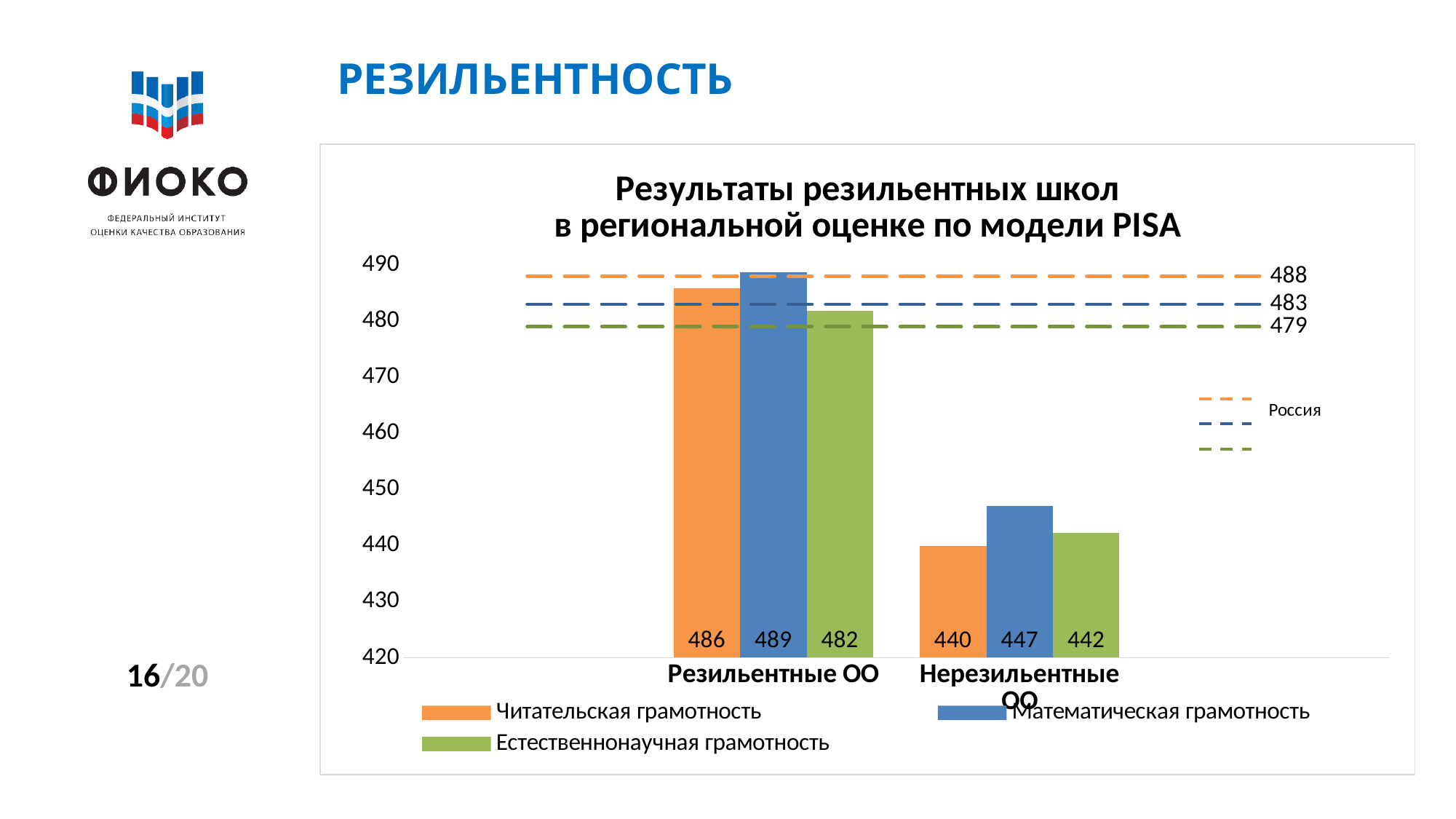
What is the value of Математическая грамотность for Резильентные ОО? 489 What is the value of Естественнонаучная грамотность for Резильентные ОО? 482 How many bar series does the legend list? 3 Which series has the lowest value for Резильентные ОО? Естественнонаучная грамотность What is the title of the chart? Результаты резильентных школ в региональной оценке по модели PISA What is the value of Читательская грамотность for Нерезильентные ОО? 440 Which series has the highest value for Нерезильентные ОО? Математическая грамотность What kind of chart is shown on the slide? bar chart Which is larger: Естественнонаучная грамотность for Резильентные ОО or for Нерезильентные ОО? Резильентные ОО How many categories are shown on the x axis? 2 What value is shown for the Россия dashed reference line for Читательская грамотность (orange)? 488 What is the difference between the Читательская грамотность values for Резильентные ОО and Нерезильентные ОО? 46